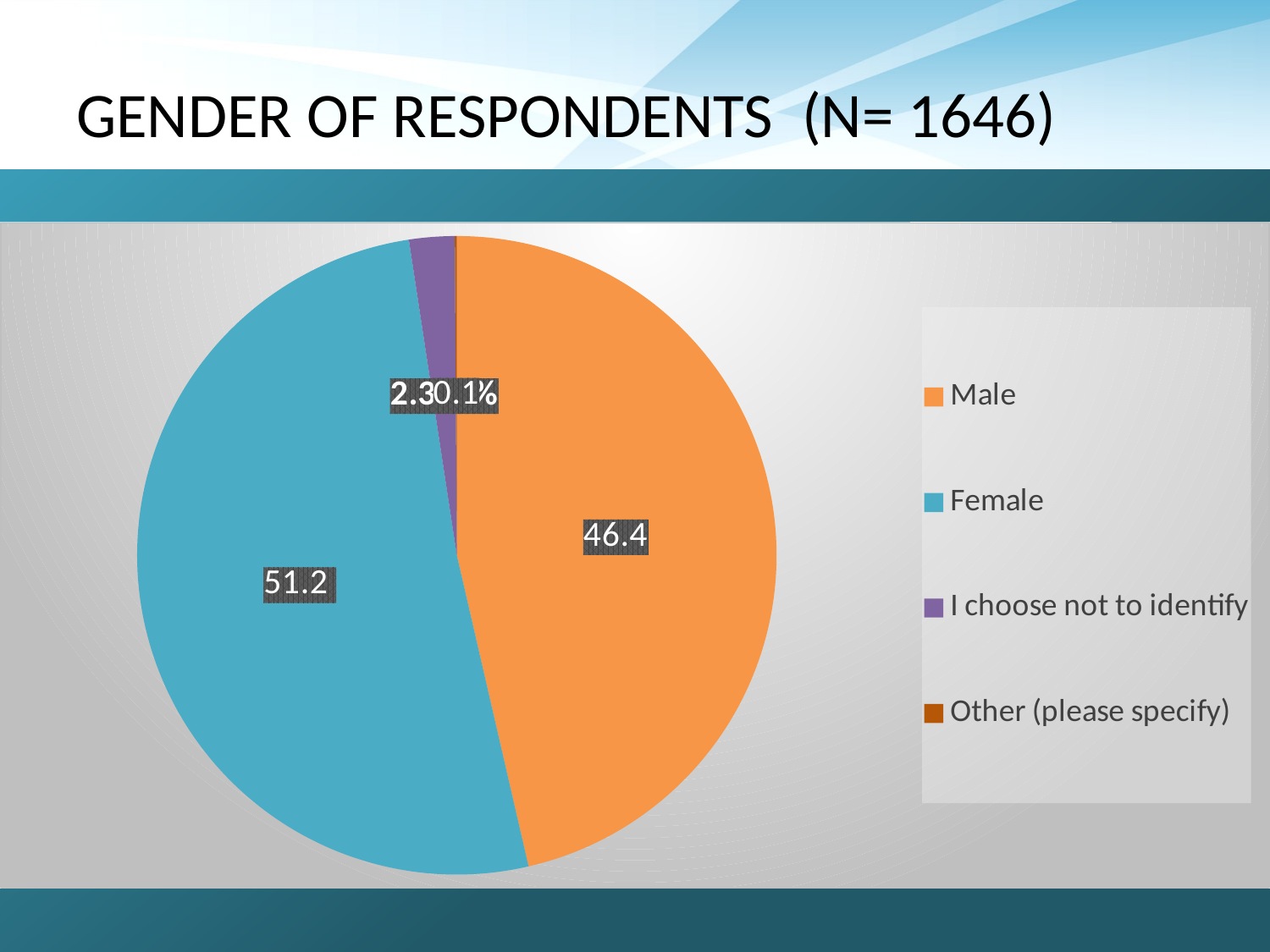
How many categories does the legend list? 4 What is the value shown for Female? 51.2 What kind of chart is shown on the slide? pie chart Is the value for Female greater or less than 50? greater Is the value for Male greater or less than 50? less What is the difference between the Female value and the Male value? 4.8 Which is larger, the Male slice or the Female slice? Female Which category has the largest slice of the pie? Female Which category is shown in purple? I choose not to identify What is the value shown for Male? 46.4 What is the title of the chart? GENDER OF RESPONDENTS (N= 1646)